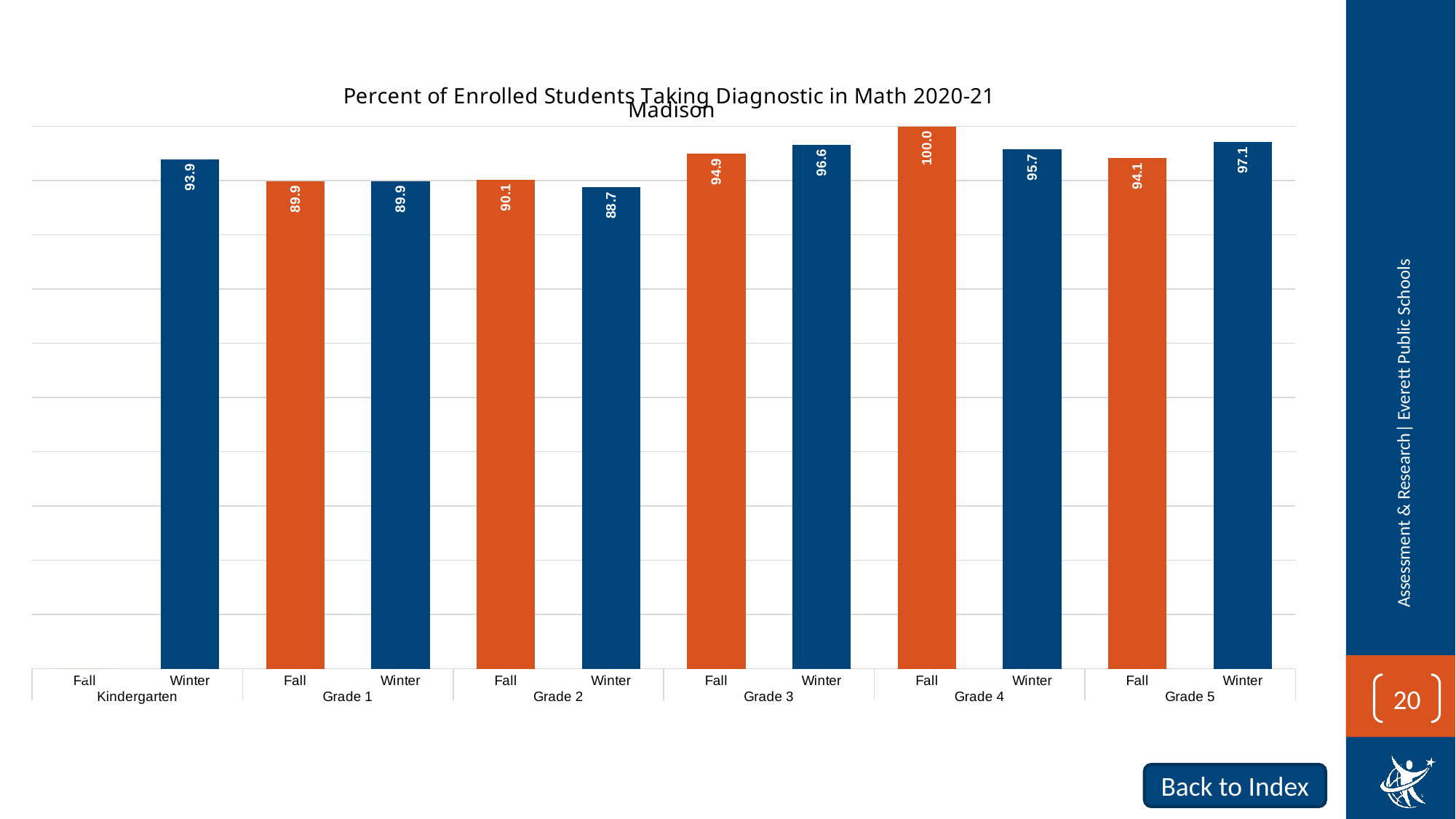
Which bar has the lowest value? Grade 2 Winter What is the difference between the Winter and Fall values in Grade 3? 1.7 What is the value for Winter in Grade 2? 88.7 Which is larger in Grade 5, the Fall value or the Winter value? Winter What is the value for Fall in Grade 4? 100.0 What is the value for Winter in Kindergarten? 93.9 What kind of chart is this? Bar chart What is the value for Fall in Grade 3? 94.9 What is the value for Winter in Grade 5? 97.1 How many grade levels are shown on the x axis? 6 What is the difference between the Fall and Winter values in Grade 4? 4.3 Which bar has the highest value? Grade 4 Fall